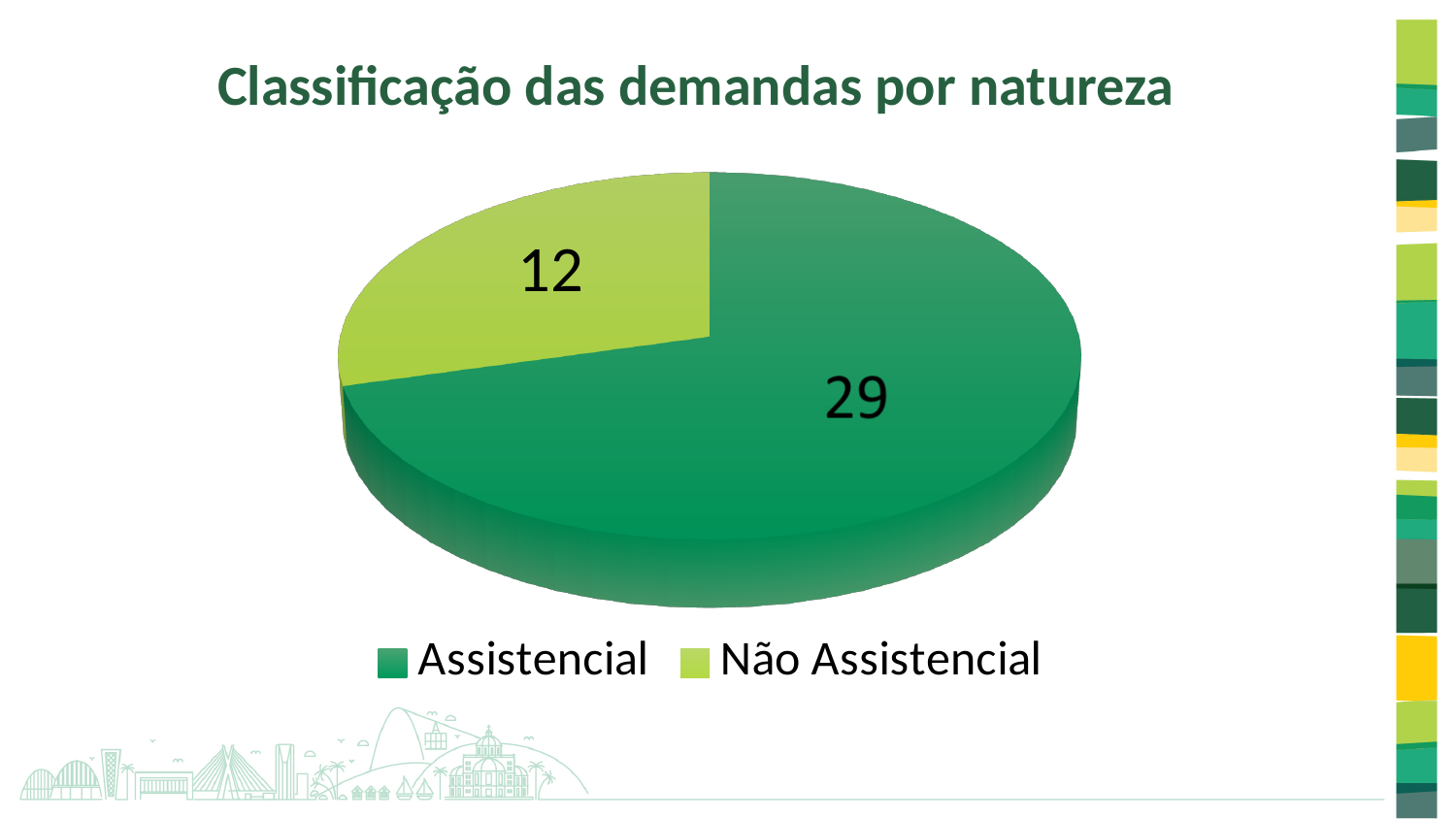
What is the title of the chart? Classificação das demandas por natureza What colour is the Não Assistencial slice? light green Which is larger, Assistencial or Não Assistencial? Assistencial What type of chart is shown on the slide? pie chart How many entries does the legend list? 2 What is the total of all slices in the pie chart? 41 What is the difference between the Assistencial and Não Assistencial values? 17 Which category has the smallest slice of the pie? Não Assistencial What is the value for Não Assistencial? 12 How many categories does the pie chart have? 2 Which category has the largest slice of the pie? Assistencial What is the value for Assistencial? 29